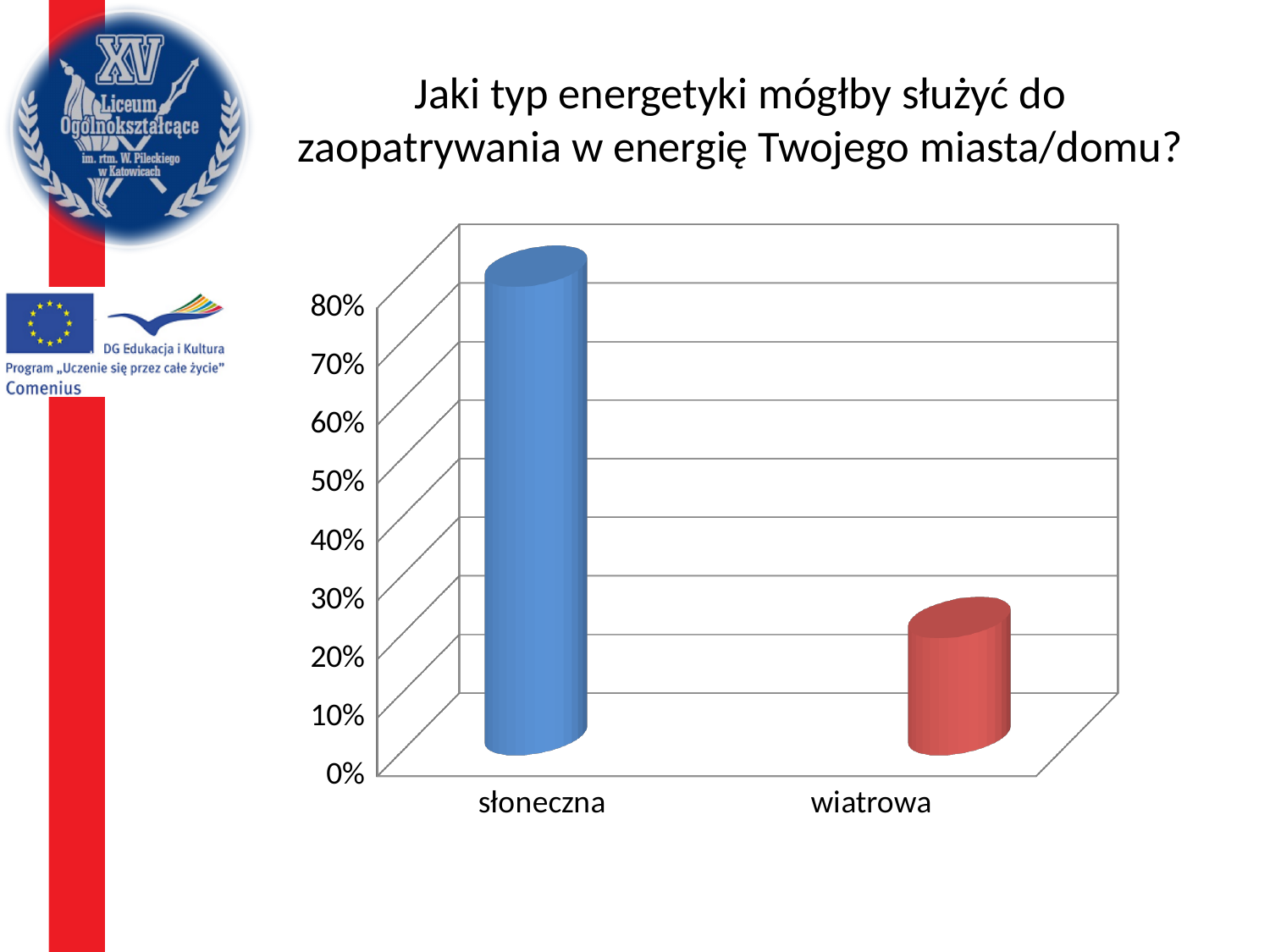
Is the value for słoneczna greater or less than 60%? greater Is the value for wiatrowa greater or less than 40%? less What is the title of the chart on the slide? Jaki typ energetyki mógłby służyć do zaopatrywania w energię Twojego miasta/domu? Is the value for wiatrowa greater or less than 10%? greater What colour is the bar for wiatrowa? red Which category has the lowest value in the chart? wiatrowa Which is larger, the value for słoneczna or the value for wiatrowa? słoneczna How many categories are shown on the x axis of the chart? 2 Which category has the highest value in the chart? słoneczna What kind of chart is shown on the slide? bar chart